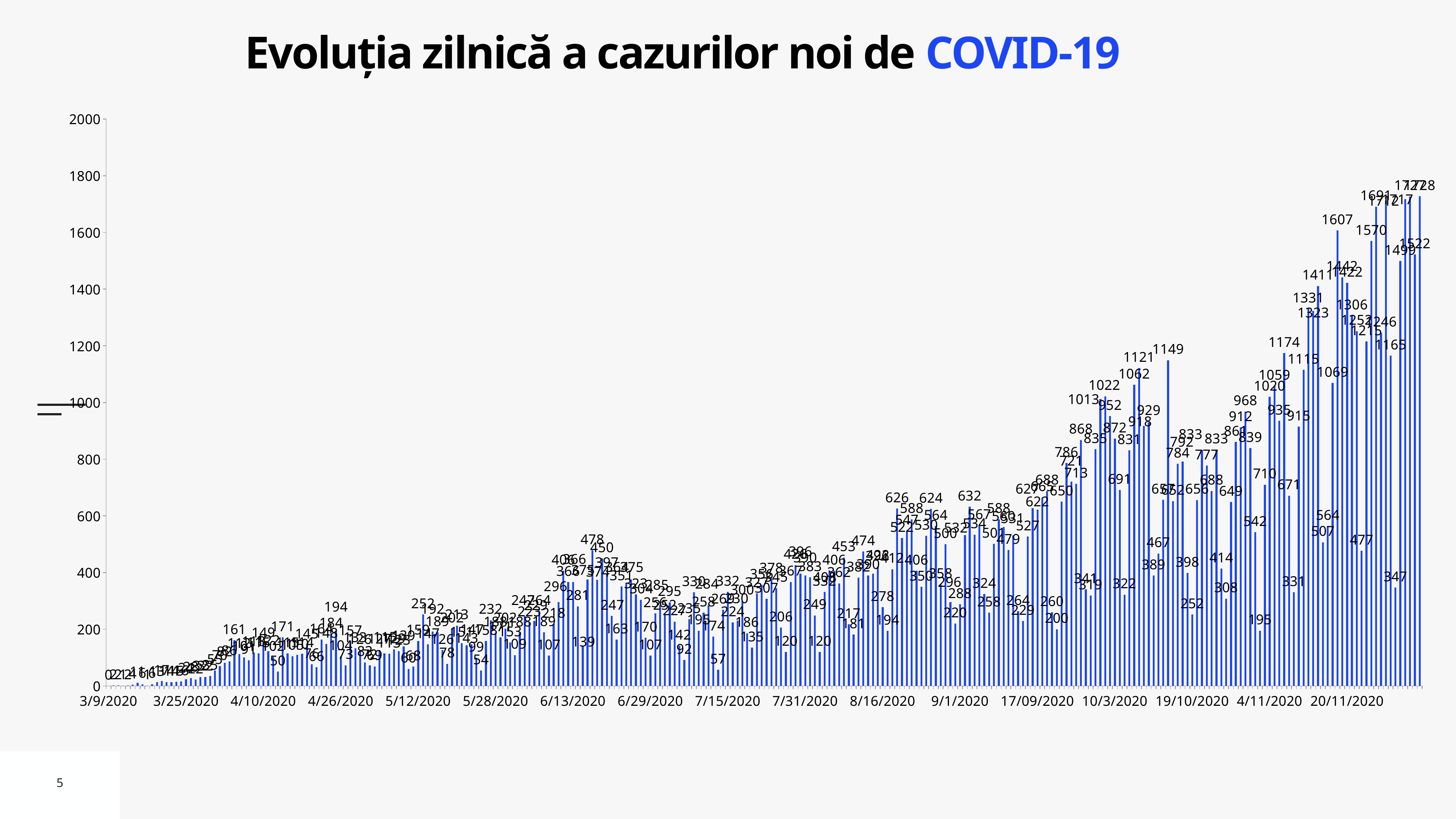
What is the peak value labeled around 6/13/2020? 478 Which period has higher values, around 6/13/2020 or around 3/25/2020? around 6/13/2020 What is the highest value labeled on the chart? 1728 Do the values generally rise or fall from left to right along the x axis? rise Is the tallest bar on the chart greater or less than 1600? greater Are the bars around 5/12/2020 greater or less than 400? less Is the value for 3/9/2020 greater or less than 200? less What is the highest value shown on the y axis? 2000 What kind of chart is shown on the slide? bar chart What is the title of the chart? Evoluția zilnică a cazurilor noi de COVID-19 How many date labels are shown on the x axis? 17